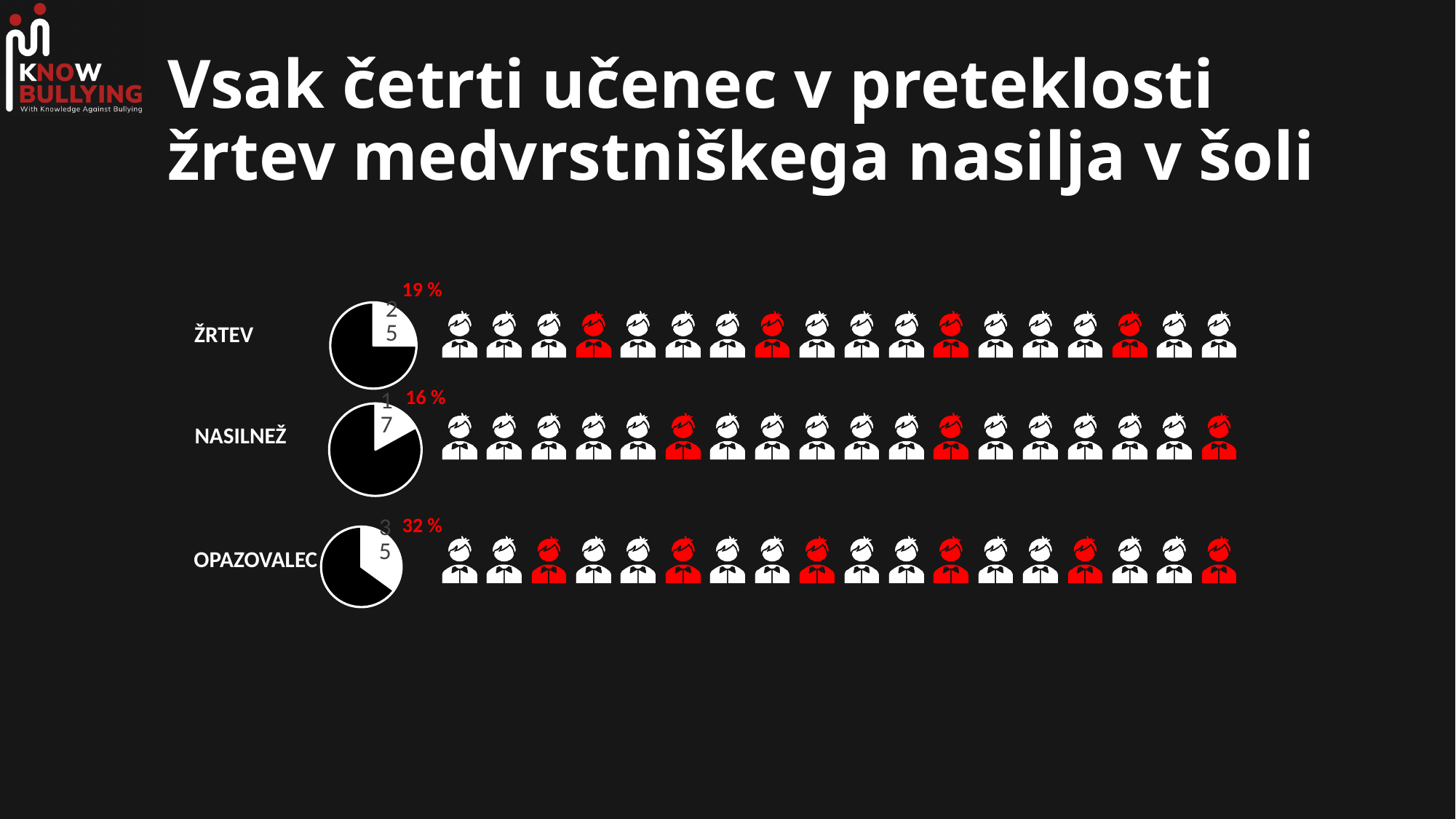
What percentage is shown for the NASILNEŽ chart? 16 % Which of the three categories (ŽRTEV, NASILNEŽ, OPAZOVALEC) has the highest percentage? OPAZOVALEC What colour are the highlighted figures in the pictogram rows? Red How many categories are shown on the slide? 3 How many red figures are in the OPAZOVALEC row of pictograms? 6 What percentage is shown for the OPAZOVALEC chart? 32 % What is the difference in percentage points between OPAZOVALEC and ŽRTEV? 13 What percentage is shown for the ŽRTEV chart? 19 % What kind of chart is used next to each category label on the left? Pie chart Which has a larger percentage, ŽRTEV or NASILNEŽ? ŽRTEV Which of the three categories (ŽRTEV, NASILNEŽ, OPAZOVALEC) has the lowest percentage? NASILNEŽ What is the difference in percentage points between ŽRTEV and NASILNEŽ? 3